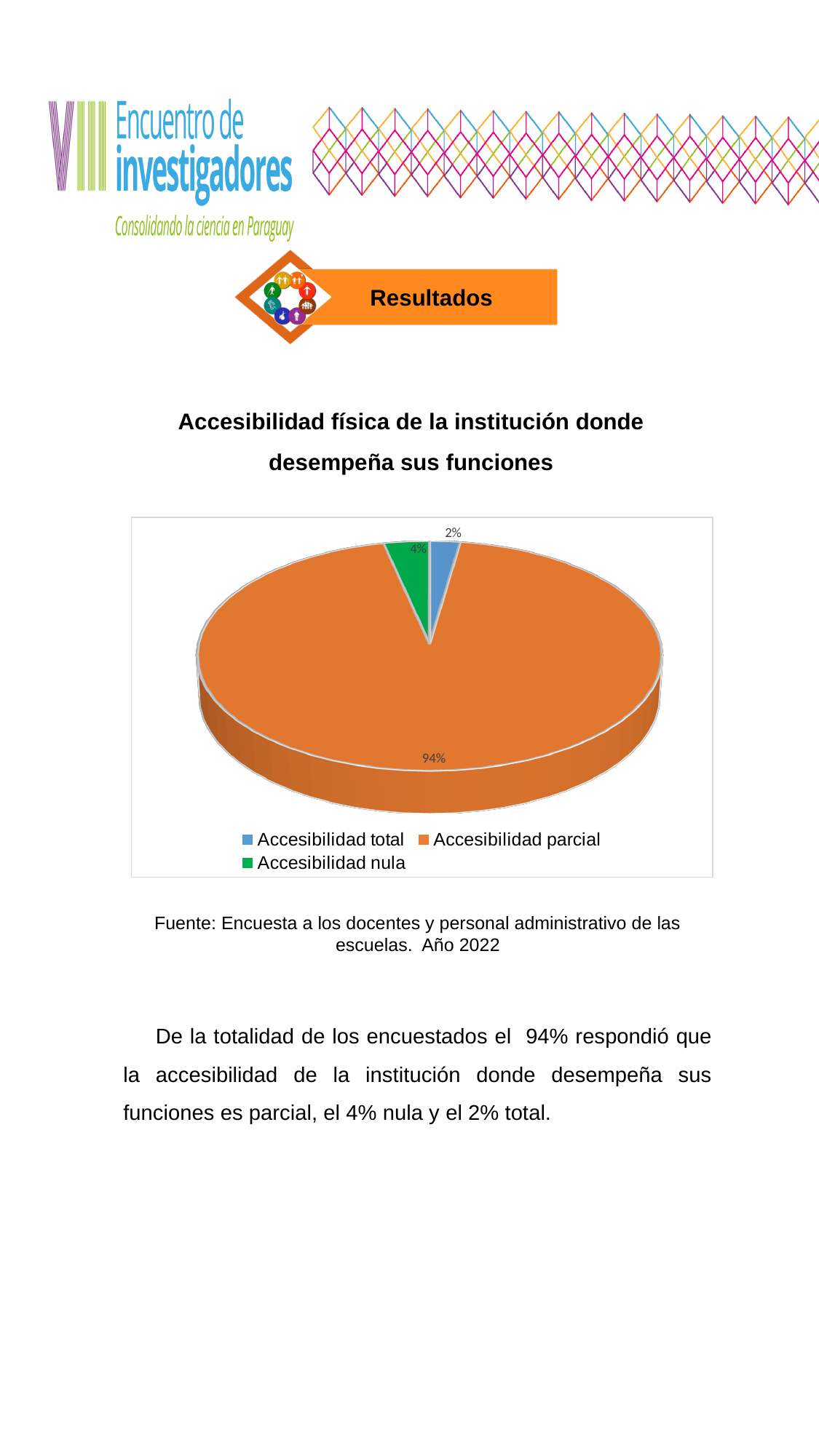
What is the difference in percentage points between Accesibilidad parcial and Accesibilidad nula? 90 Which is larger, the slice for Accesibilidad nula or the slice for Accesibilidad total? Accesibilidad nula Which category has the smallest slice of the pie? Accesibilidad total What kind of chart is shown on the slide? Pie chart What is the difference in percentage points between Accesibilidad nula and Accesibilidad total? 2 What is the title of the chart? Accesibilidad física de la institución donde desempeña sus funciones How many categories does the pie chart show? 3 What share of the pie does Accesibilidad total represent? 2% What share of the pie does Accesibilidad nula represent? 4% Which category has the largest slice of the pie? Accesibilidad parcial What colour is the slice for Accesibilidad nula? Green What share of the pie does Accesibilidad parcial represent? 94%